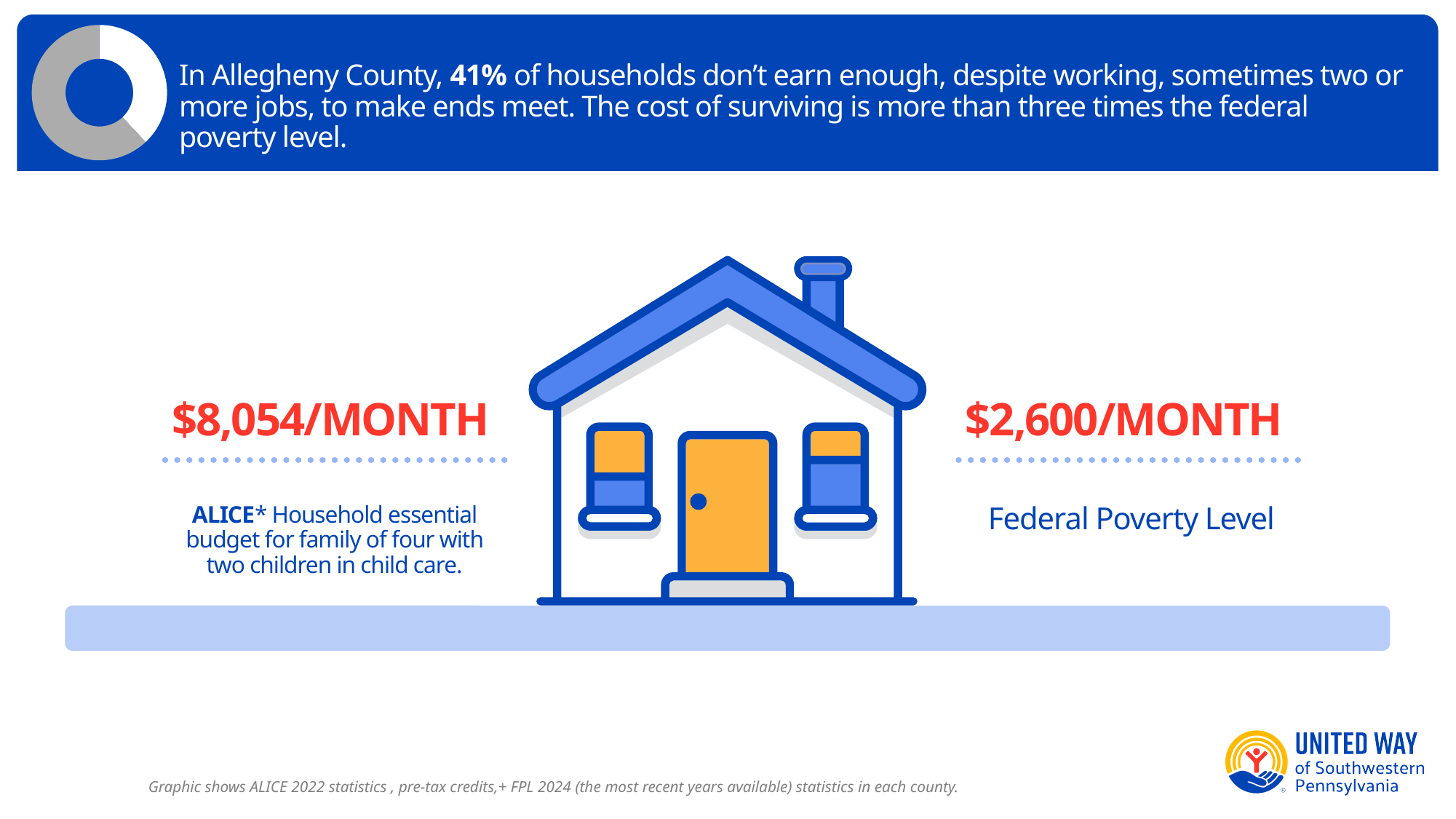
What kind of chart is shown in the top-left corner of the slide? Donut (pie) chart What is the difference between the ALICE Household essential budget ($8,054/month) and the Federal Poverty Level ($2,600/month)? $5,454 Which of the two monthly figures on the slide is the lowest? Federal Poverty Level ($2,600/MONTH) Is the ALICE Household essential budget per month greater or less than $8,000? greater How many segments does the donut chart in the top-left corner have? 2 What is the Federal Poverty Level per month shown on the slide? $2,600/MONTH What colour is used for the two monthly dollar figures on the slide? Red What is the ALICE Household essential budget per month for a family of four with two children in child care? $8,054/MONTH Is the share of households that don't earn enough, shown by the donut chart, greater or less than 50%? less According to the slide, what share of households in Allegheny County don't earn enough to make ends meet, as represented by the donut chart? 41% Which is larger: the ALICE Household essential budget or the Federal Poverty Level? ALICE Household essential budget Which county does the slide's statistic refer to? Allegheny County